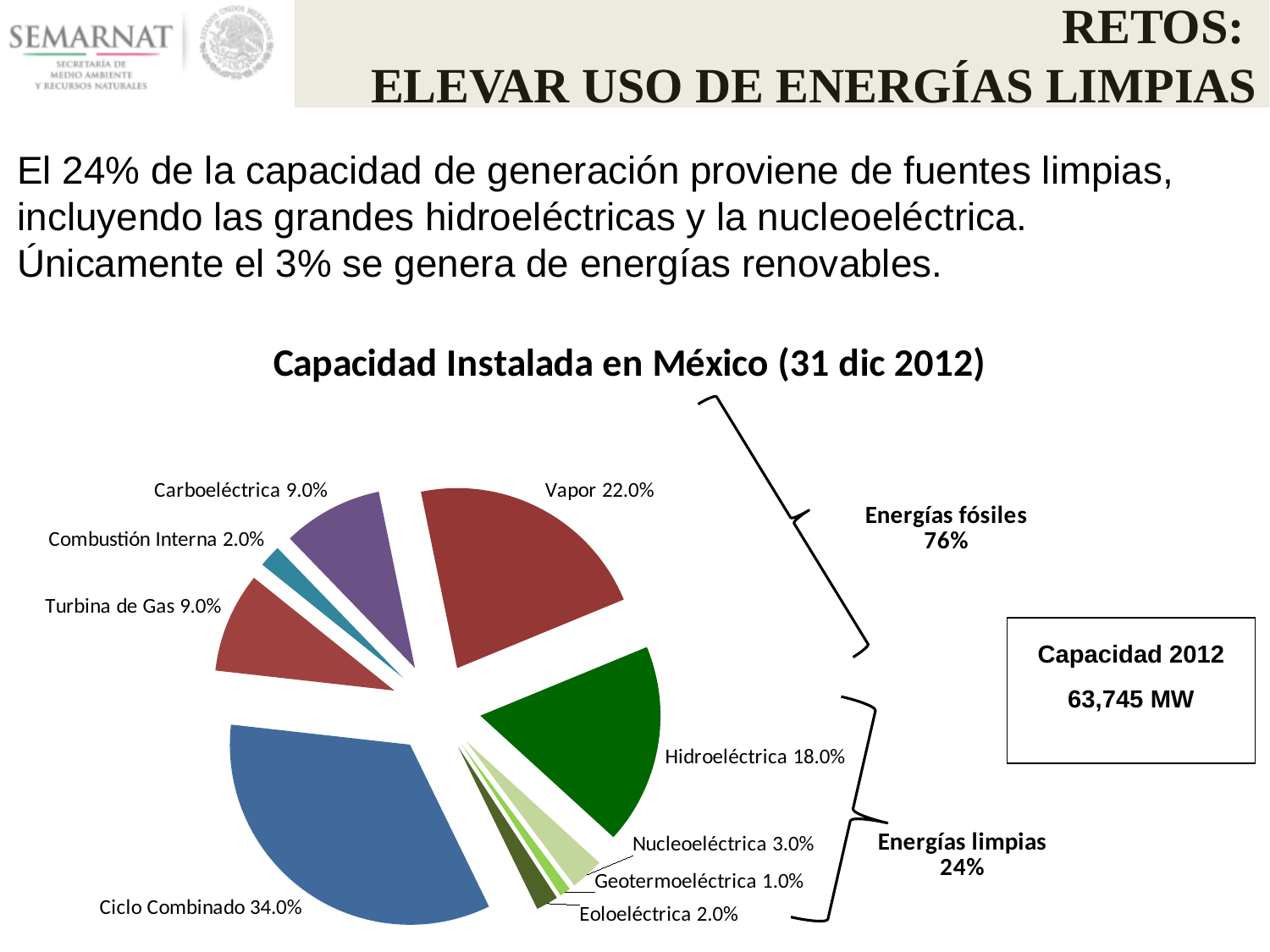
How many slices does the pie chart have? 9 What kind of chart is shown on the slide? pie chart What share of the pie does Ciclo Combinado represent? 34.0% Which is larger, the share for Nucleoeléctrica or the share for Eoloeléctrica? Nucleoeléctrica Which category has the smallest slice of the pie? Geotermoeléctrica What is the value shown for Vapor? 22.0% Which category has the largest slice of the pie? Ciclo Combinado What is the difference between the Vapor and Hidroeléctrica shares? 4.0% What is the title of the chart? Capacidad Instalada en México (31 dic 2012) What is the value shown for Hidroeléctrica? 18.0% What percentage of the pie is grouped as Energías limpias? 24% What is the value shown for Geotermoeléctrica? 1.0%